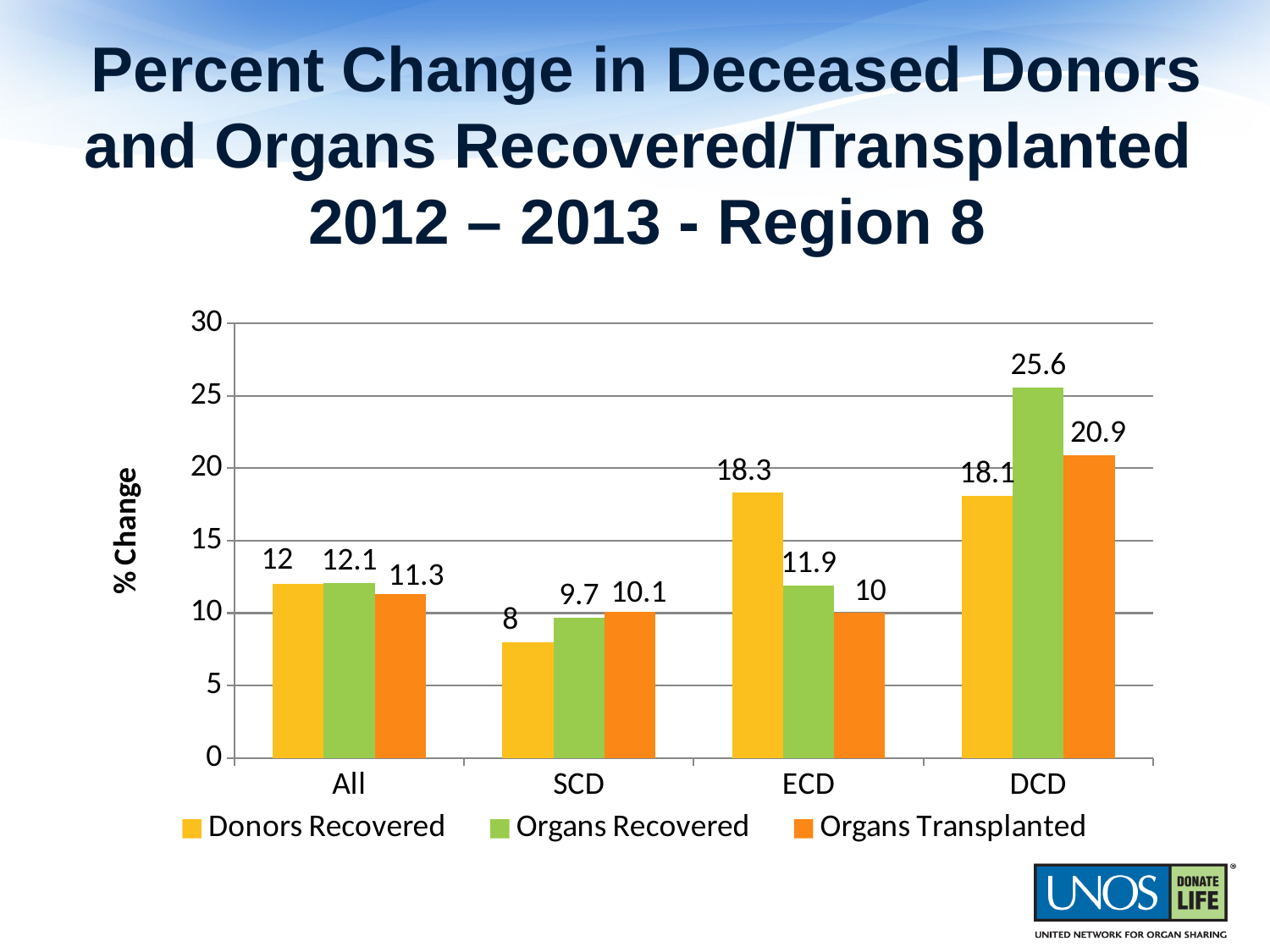
Is the value for Organs Recovered in the DCD category greater or less than 25? greater What is the value for Donors Recovered in the ECD category? 18.3 What kind of chart is shown on the slide? bar chart Which is larger in the ECD category: Donors Recovered or Organs Recovered? Donors Recovered Which category has the highest Organs Recovered value? DCD How many categories are shown on the x axis? 4 Which category has the lowest Donors Recovered value? SCD How many series does the legend list? 3 What is the value for Organs Recovered in the DCD category? 25.6 What is the label of the y axis? % Change What is the value for Organs Transplanted in the SCD category? 10.1 What is the difference between Organs Recovered and Organs Transplanted in the DCD category? 4.7